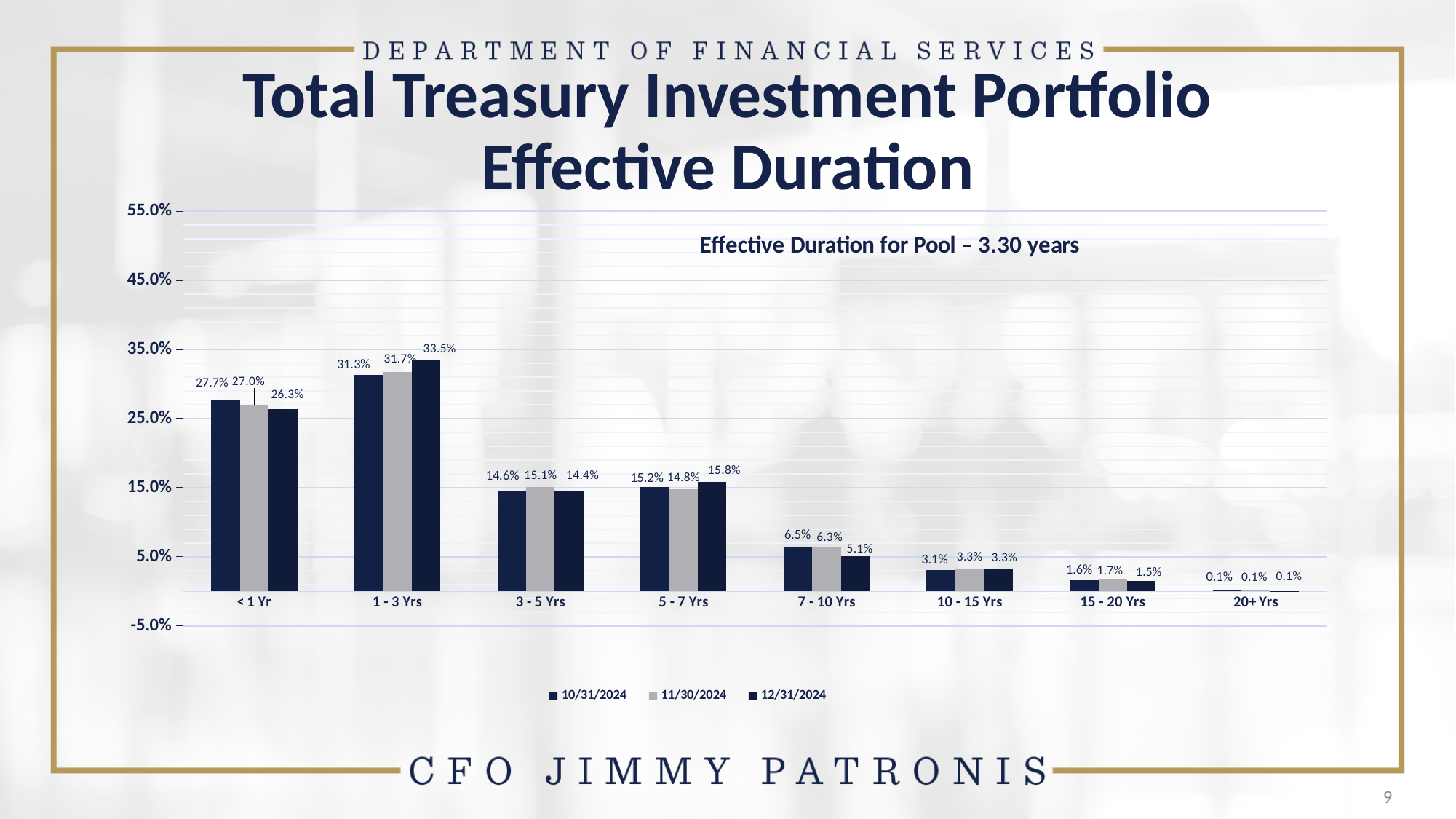
Do the 12/31/2024 values rise or fall from the 1 - 3 Yrs category to the 20+ Yrs category? Fall What is the value for the < 1 Yr category in the 11/30/2024 series? 27.0% What is the value for the 1 - 3 Yrs category in the 12/31/2024 series? 33.5% What effective duration for the pool is stated on the chart? 3.30 years What kind of chart is shown on the slide? Bar chart Which category has the lowest value in the 10/31/2024 series? 20+ Yrs How many series does the legend list? 3 Which category has the highest value in the 12/31/2024 series? 1 - 3 Yrs What is the difference between the 12/31/2024 and 10/31/2024 values for the 1 - 3 Yrs category? 2.2% How many categories are shown on the x axis? 8 Which is larger for the 5 - 7 Yrs category: the 10/31/2024 value or the 12/31/2024 value? 12/31/2024 What is the value for the 7 - 10 Yrs category in the 10/31/2024 series? 6.5%